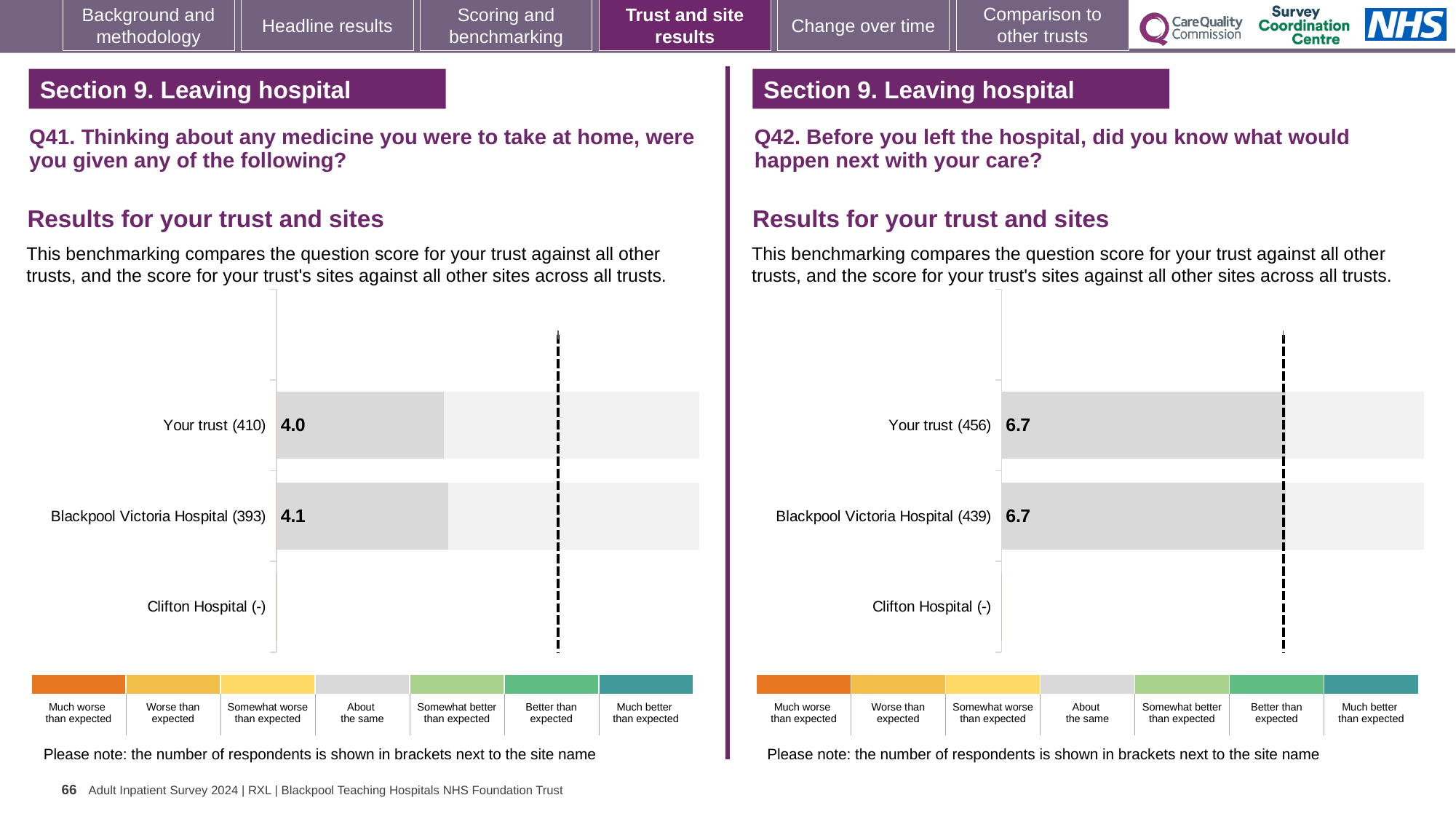
In the Q41 chart on the left, what is the difference between the scores for Blackpool Victoria Hospital and Your trust? 0.1 In the Q42 chart on the right, how many respondents are shown in brackets for Blackpool Victoria Hospital? 439 In the Q42 chart on the right, what is the difference between the scores for Your trust and Blackpool Victoria Hospital? 0.0 In the Q41 chart on the left, which has the higher score, Your trust or Blackpool Victoria Hospital? Blackpool Victoria Hospital How many categories are listed on the y axis of the Q41 chart on the left? 3 What kind of chart is the Q42 chart on the right? Bar chart In the Q41 chart on the left, what is the score for Blackpool Victoria Hospital? 4.1 In the Q41 chart on the left, how many respondents are shown in brackets for Your trust? 410 In the Q42 chart on the right, what is the score for Blackpool Victoria Hospital? 6.7 In the Q41 chart on the left, what is the score for Your trust? 4.0 In the Q42 chart on the right, what is the score for Your trust? 6.7